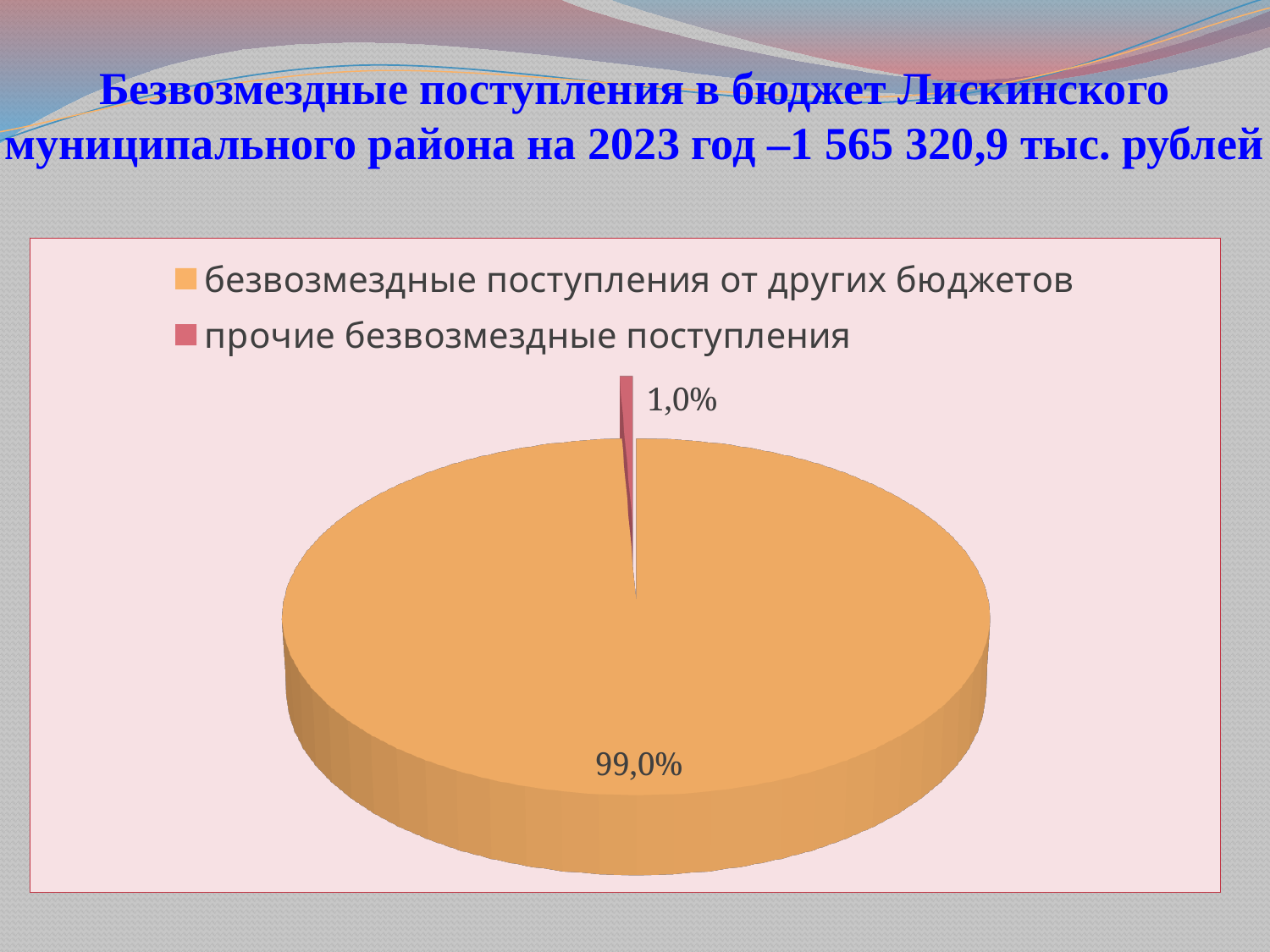
What total amount of gratuitous receipts for 2023 is stated in the slide title? 1 565 320,9 тыс. рублей What share of the pie does 'прочие безвозмездные поступления' take? 1,0% How many entries does the legend list? 2 What kind of chart is shown on the slide? pie chart What share of the pie does 'безвозмездные поступления от других бюджетов' take? 99,0% How many slices does the pie chart have? 2 Which category has the smallest slice of the pie? прочие безвозмездные поступления What is the difference in percentage points between the two slices? 98,0% What colour is the slice for 'прочие безвозмездные поступления'? red Which is larger: 'безвозмездные поступления от других бюджетов' or 'прочие безвозмездные поступления'? безвозмездные поступления от других бюджетов Which category has the largest slice of the pie? безвозмездные поступления от других бюджетов